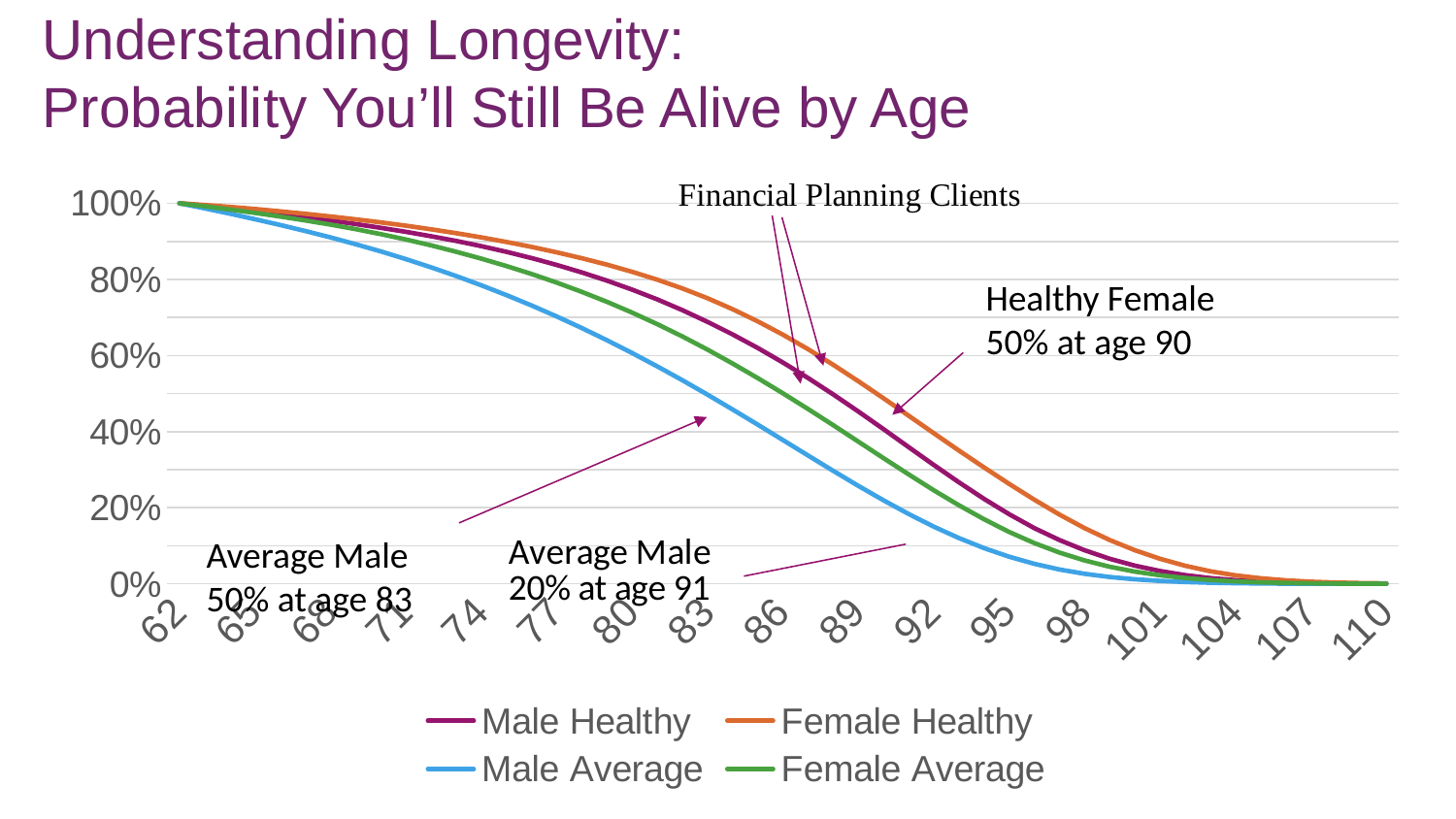
Is the value for Female Healthy at age 80 greater or less than 60%? greater According to the annotation, what is the probability of still being alive for a Healthy Female at age 90? 50% Which series has the highest value at age 92? Female Healthy What are the first and last ages shown on the x axis? 62 and 110 Do the probability values rise or fall as age increases along the x axis? fall At age 86, which is higher: Female Healthy or Male Average? Female Healthy How many series does the legend list? 4 Which series are listed in the legend? Male Healthy, Female Healthy, Male Average, Female Average Is the value for Male Average at age 95 greater or less than 20%? less According to the annotation, what is the Average Male probability of still being alive at age 91? 20% What kind of chart is shown on the slide? line chart According to the annotation, at what age does the Average Male probability reach 50%? 83